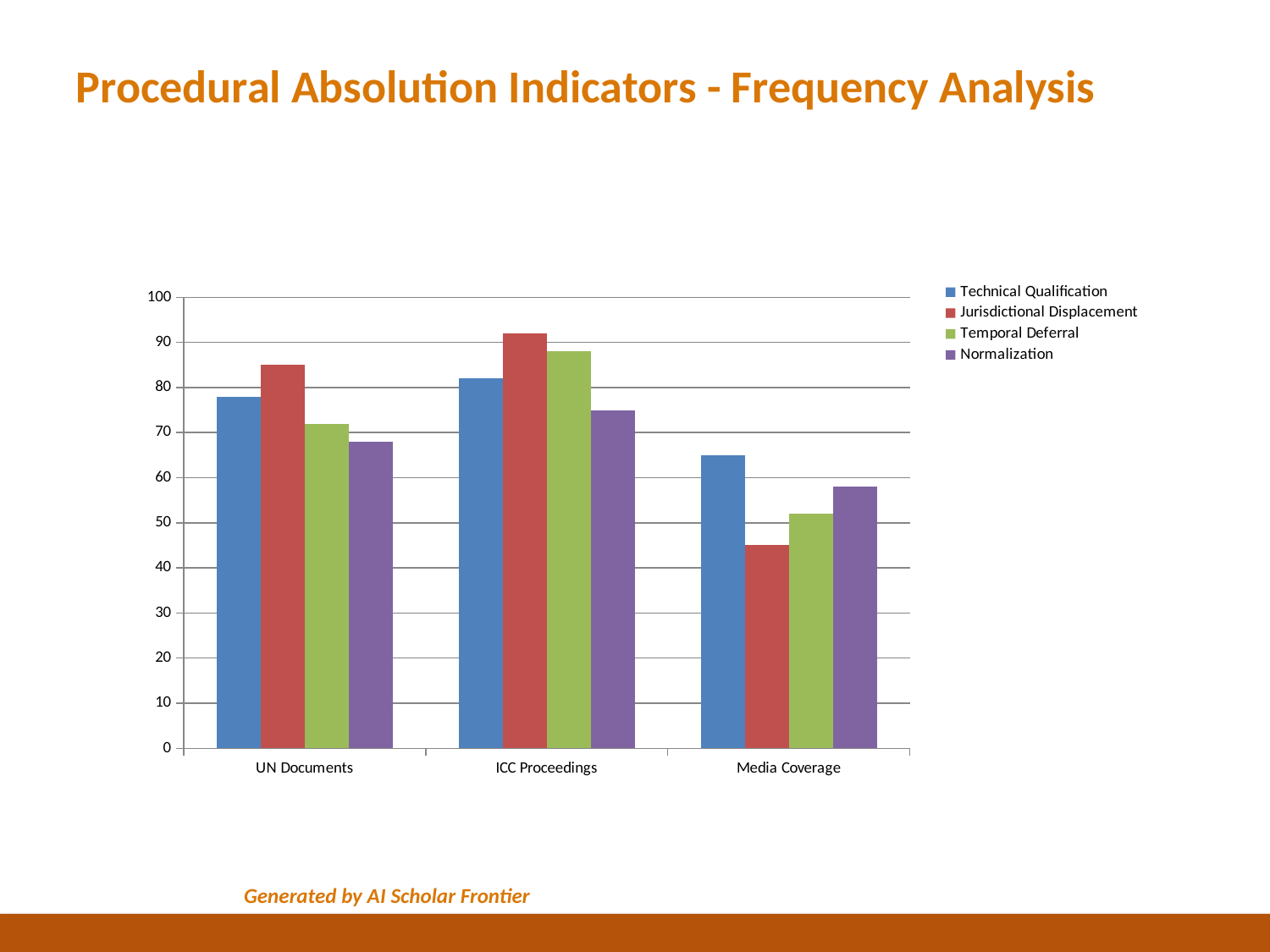
What kind of chart is shown on the slide? bar chart Is the value for Temporal Deferral in ICC Proceedings greater or less than 80? greater What is the title of the slide containing the chart? Procedural Absolution Indicators - Frequency Analysis Which category has the lowest value for Jurisdictional Displacement? Media Coverage How many categories are shown on the x axis of the chart? 3 Which series has the highest value within the Media Coverage category? Technical Qualification Is the value for Technical Qualification in UN Documents greater or less than 70? greater Which category has the highest value for Jurisdictional Displacement? ICC Proceedings How many series does the chart's legend list? 4 In Media Coverage, which is larger: Technical Qualification or Temporal Deferral? Technical Qualification In ICC Proceedings, which is larger: Jurisdictional Displacement or Normalization? Jurisdictional Displacement Is the value for Jurisdictional Displacement in Media Coverage greater or less than 50? less